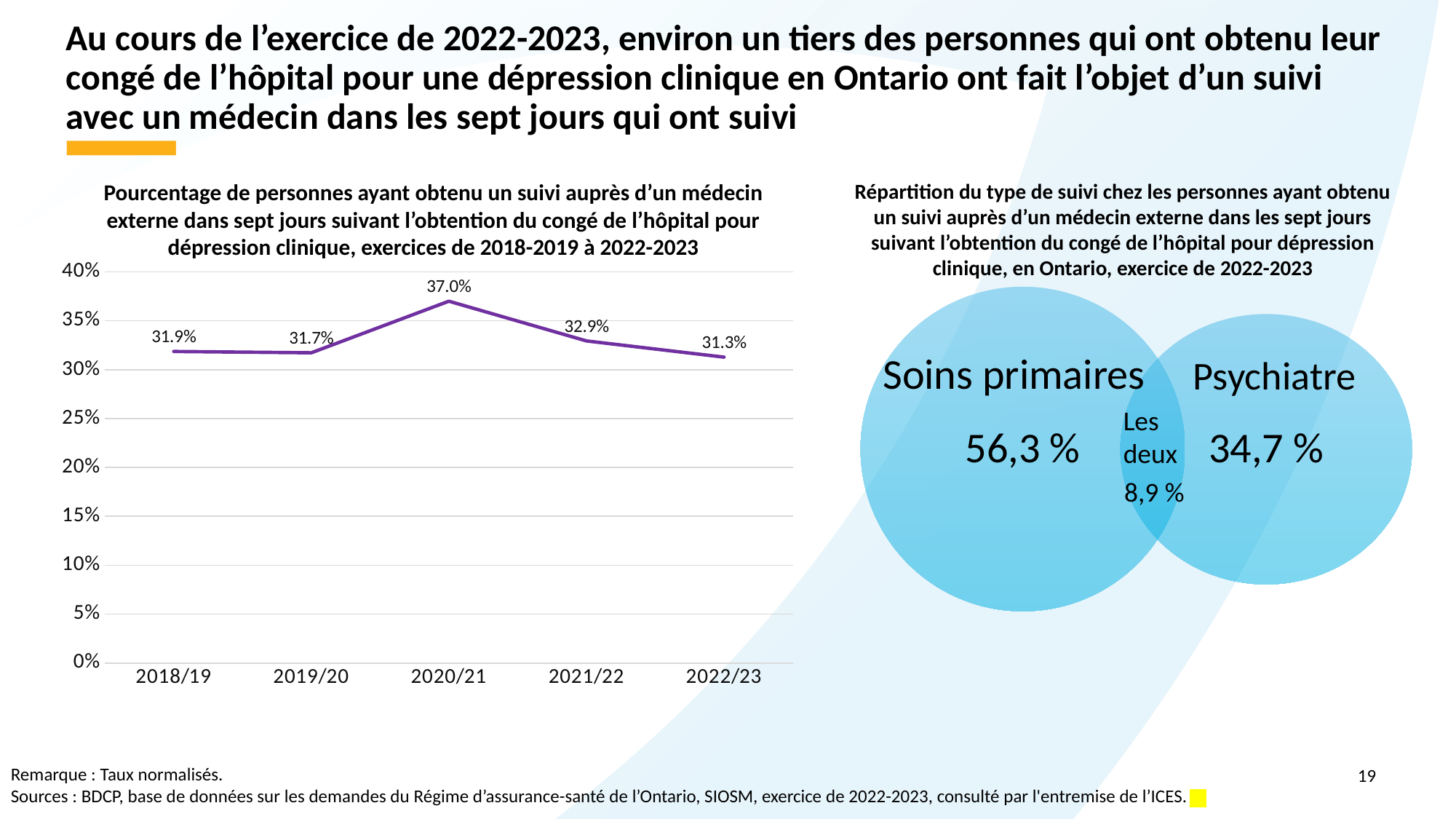
In the Venn diagram on the right, which is larger, Soins primaires or Psychiatre? Soins primaires In the line chart on the left, which is larger, the value for 2018/19 or the value for 2021/22? 2021/22 In the line chart on the left, how many fiscal years are plotted? 5 In the Venn diagram on the right, what is the value for Soins primaires? 56,3 % In the line chart on the left, which fiscal year has the highest value? 2020/21 In the line chart on the left, which fiscal year has the lowest value? 2022/23 In the line chart on the left, what is the value for 2022/23? 31.3% In the line chart on the left, what is the value for 2020/21? 37.0% In the Venn diagram on the right, what is the value for Les deux (the overlap)? 8,9 % In the line chart on the left, does the value rise or fall from 2020/21 to 2022/23? Fall In the line chart on the left, what is the difference between the values for 2020/21 and 2021/22? 4.1 percentage points What kind of chart is shown on the left of the slide? Line chart